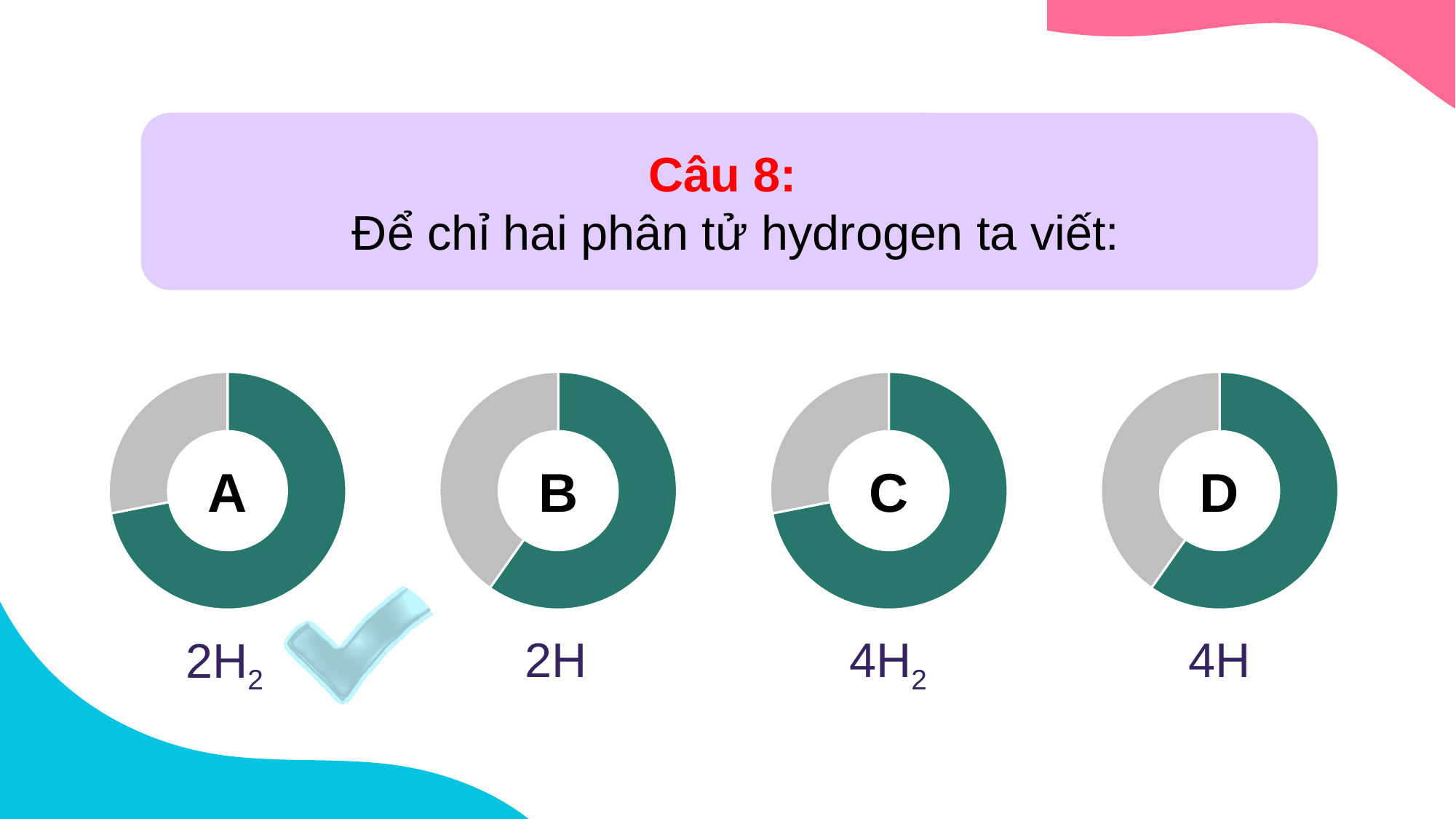
In the donut chart labelled C, which segment is larger, the green one or the grey one? Green How many segments does each donut chart on the slide have? 2 What kind of chart is used for each of the four answer options on the slide? Donut (pie) chart In the donut chart labelled D, which segment is larger, the green one or the grey one? Green In the donut chart labelled B, which segment is larger, the green one or the grey one? Green What label is written below the donut chart marked C? 4H2 How many donut charts are shown on the slide? 4 Which letter appears in the centre of the donut chart above the label 2H2? A